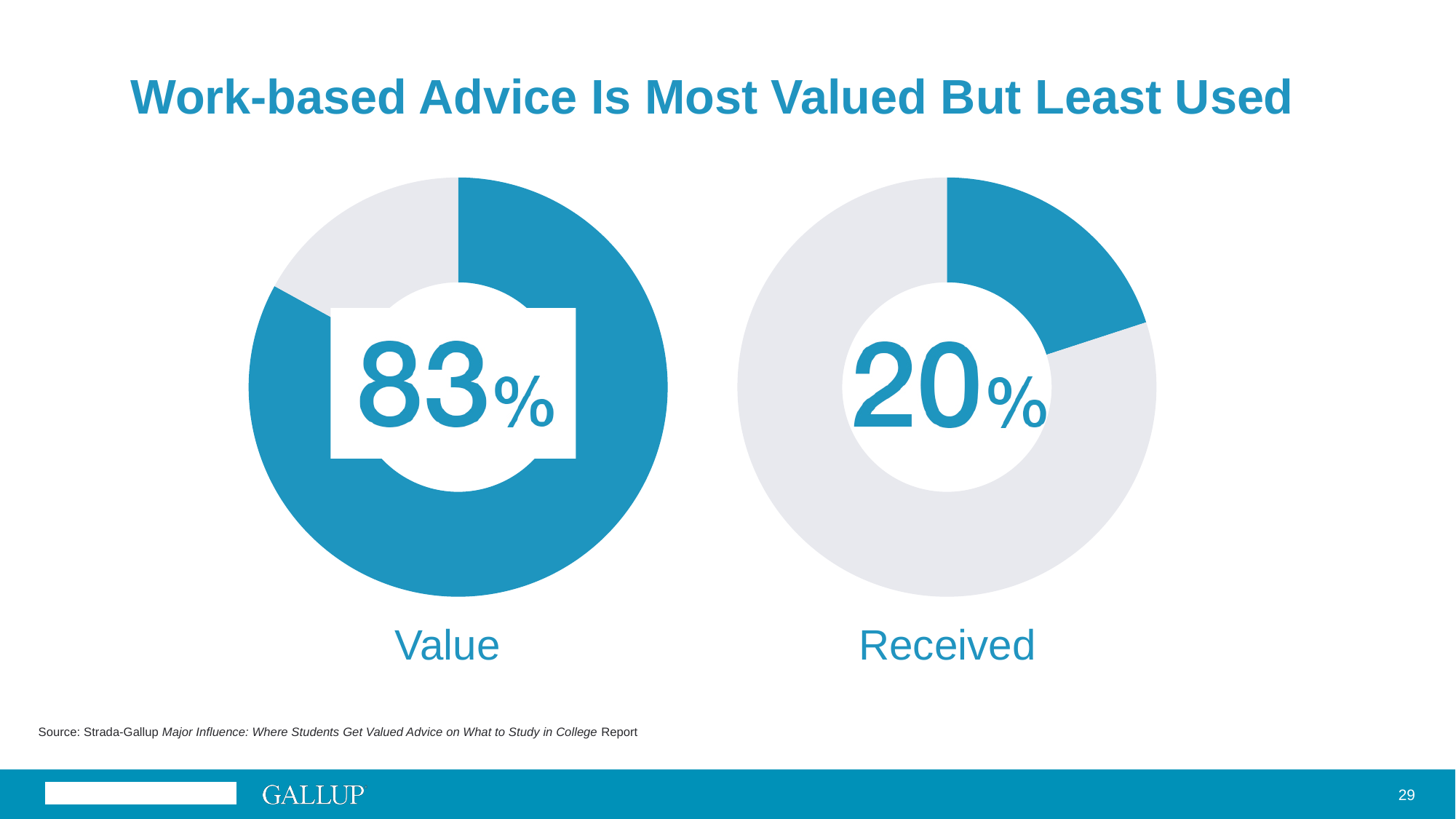
On the Value donut chart, what share of the ring is filled in blue? 83% Which of the two donut charts shows the lower percentage, Value or Received? Received What are the labels beneath the left and right donut charts? Value and Received On the right donut chart labelled "Received", what percentage is shown? 20% How many donut charts are on the slide? 2 What is the difference between the Value percentage and the Received percentage? 63 percentage points On the left donut chart labelled "Value", what percentage is shown? 83% What is the title of the slide containing the two donut charts? Work-based Advice Is Most Valued But Least Used What kind of chart is used to show the Value and Received percentages? Donut (pie) chart On the Received donut chart, what share of the ring is filled in blue? 20% Which of the two donut charts shows the higher percentage, Value or Received? Value